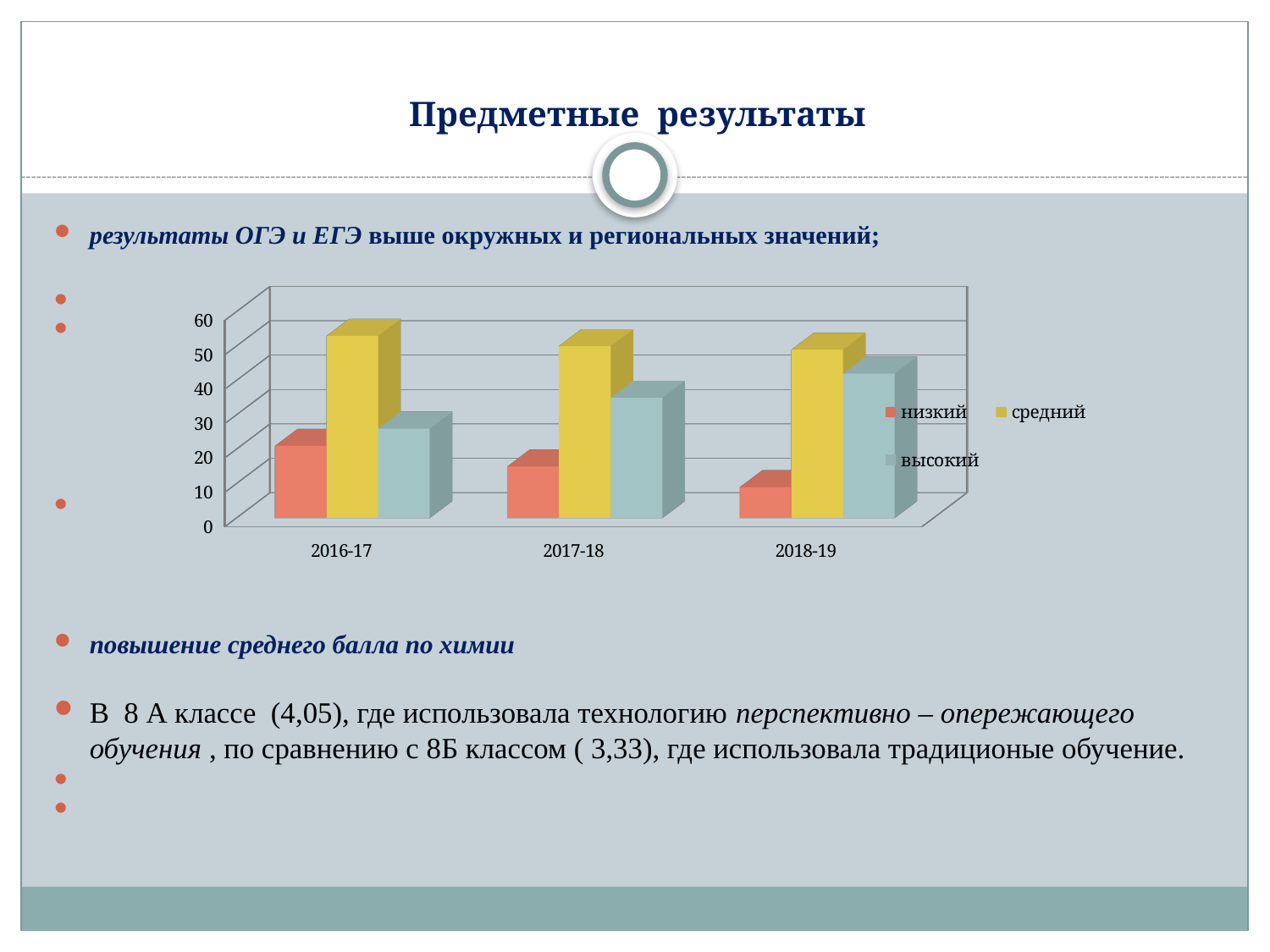
Does the value for высокий rise or fall from 2016-17 to 2018-19? rise Which is larger: the низкий value for 2016-17 or the низкий value for 2018-19? 2016-17 Is the value for средний in 2016-17 greater or less than 40? greater How many series does the chart legend list? 3 Does the value for низкий rise or fall from 2016-17 to 2018-19? fall What kind of chart is shown on the slide? bar chart Is the value for низкий in 2018-19 greater or less than 20? less Which series has the highest bar in the 2016-17 group? средний How many categories (school years) are shown on the x axis of the chart? 3 What are the series names listed in the chart legend? низкий, средний, высокий Which is larger: the высокий value for 2016-17 or the высокий value for 2018-19? 2018-19 Which series has the lowest bar in the 2016-17 group? низкий